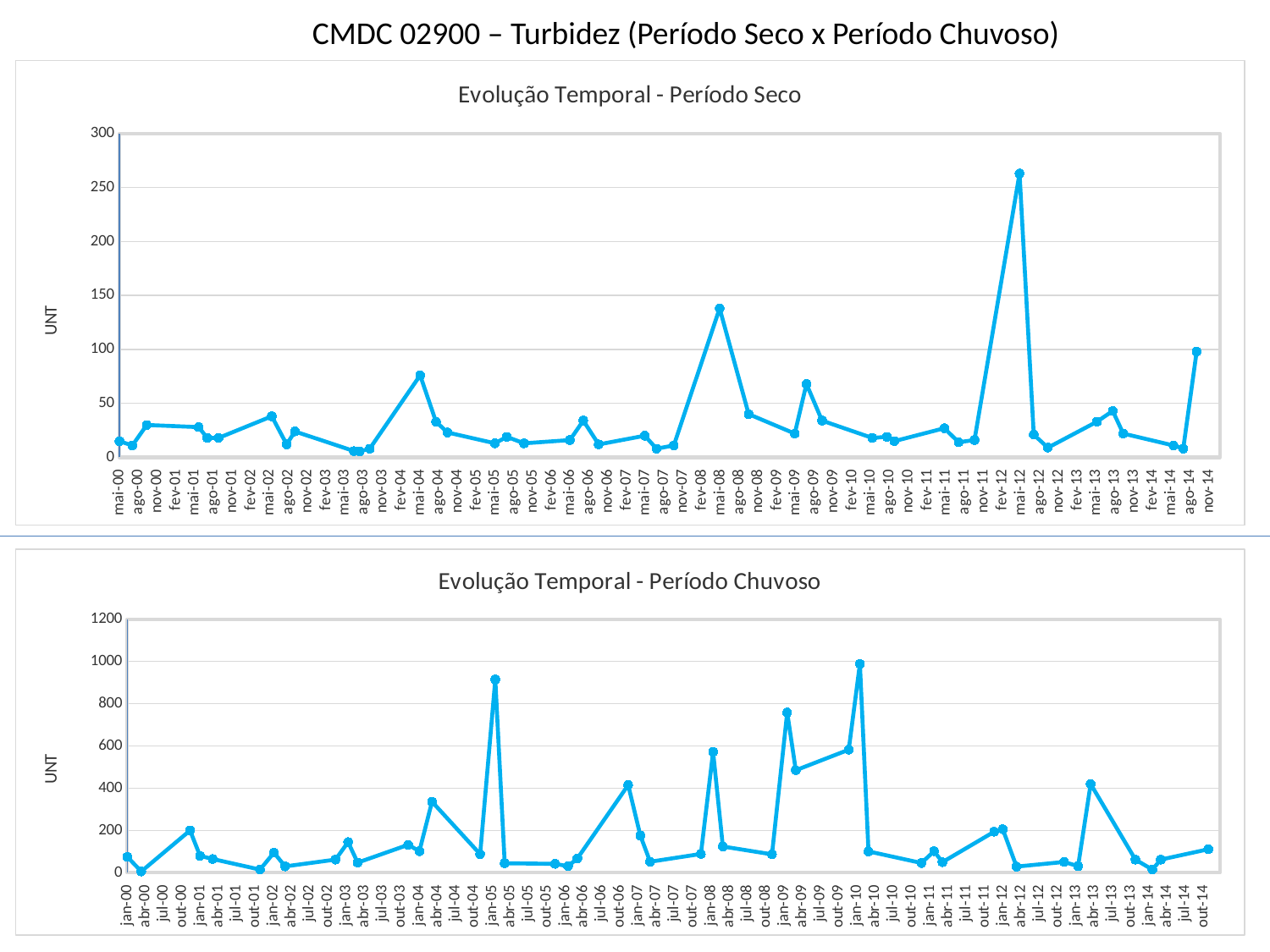
In the 'Evolução Temporal - Período Seco' chart, is the value for mai-08 greater or less than 100? greater What is the main title at the top of the slide? CMDC 02900 – Turbidez (Período Seco x Período Chuvoso) What kind of chart is the 'Evolução Temporal - Período Seco' chart? line chart In the 'Evolução Temporal - Período Seco' chart, which is larger, the value for mai-12 or the value for mai-08? mai-12 In the 'Evolução Temporal - Período Seco' chart, is the value for mai-12 greater or less than 250? greater In the 'Evolução Temporal - Período Chuvoso' chart, which is larger, the value for jan-09 or the value for jan-08? jan-09 In the 'Evolução Temporal - Período Seco' chart, which date has the highest value? mai-12 In the 'Evolução Temporal - Período Seco' chart, is the value for mai-04 greater or less than 50? greater What is the y-axis label on the 'Evolução Temporal - Período Chuvoso' chart? UNT In the 'Evolução Temporal - Período Chuvoso' chart, which date has the highest value? jan-10